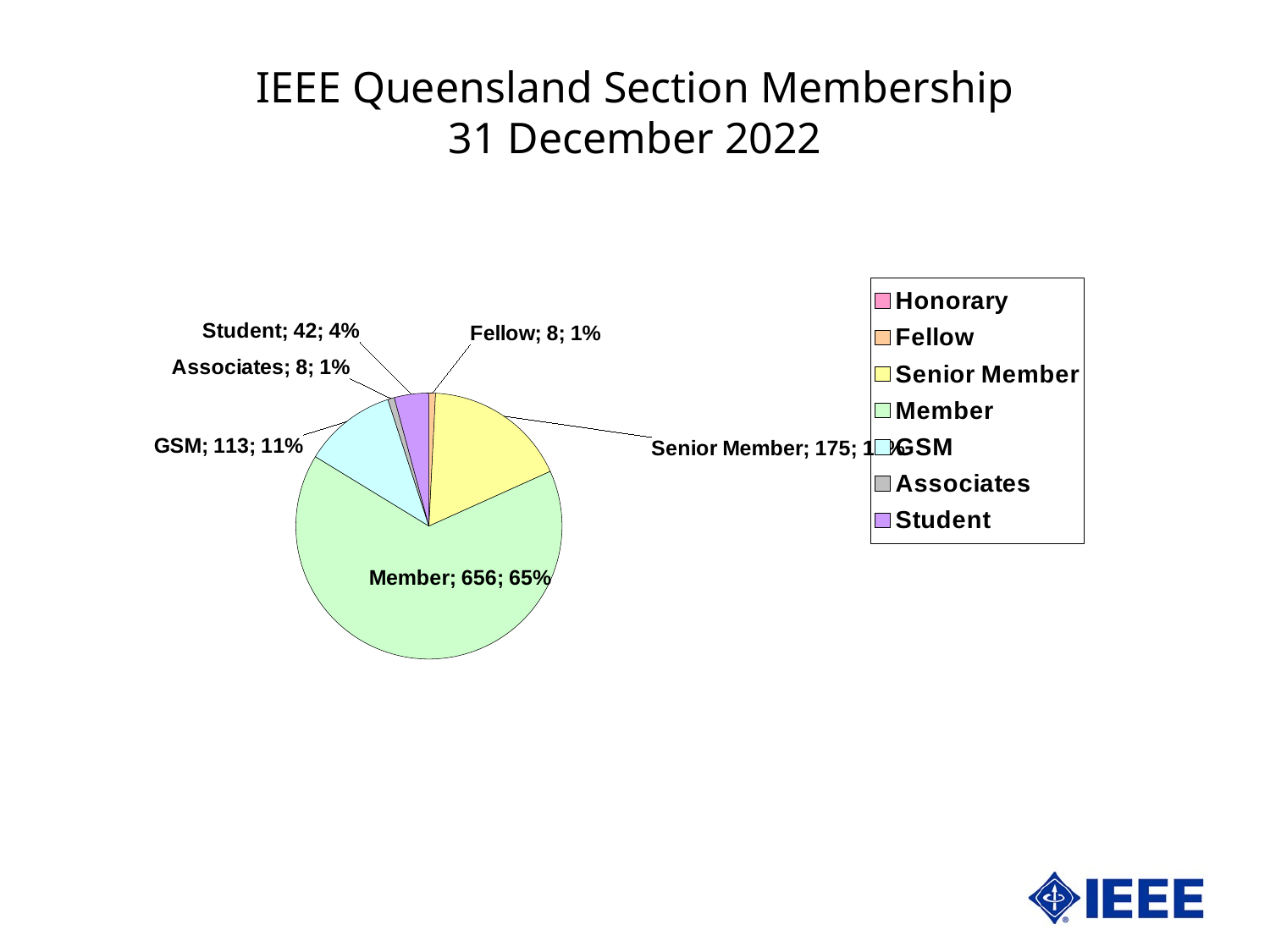
What share of the pie does the GSM slice represent? 11% How many members are in the Senior Member category? 175 Which category has the largest slice of the pie? Member Which has a larger count, GSM or Student? GSM What is the difference in count between Member and Senior Member? 481 How many members are in the GSM category? 113 What share of the pie does the Member slice represent? 65% How many entries does the legend list? 7 What kind of chart is shown on the slide? pie chart How many members are in the Member category? 656 How many members are in the Student category? 42 What is the difference in count between GSM and Student? 71